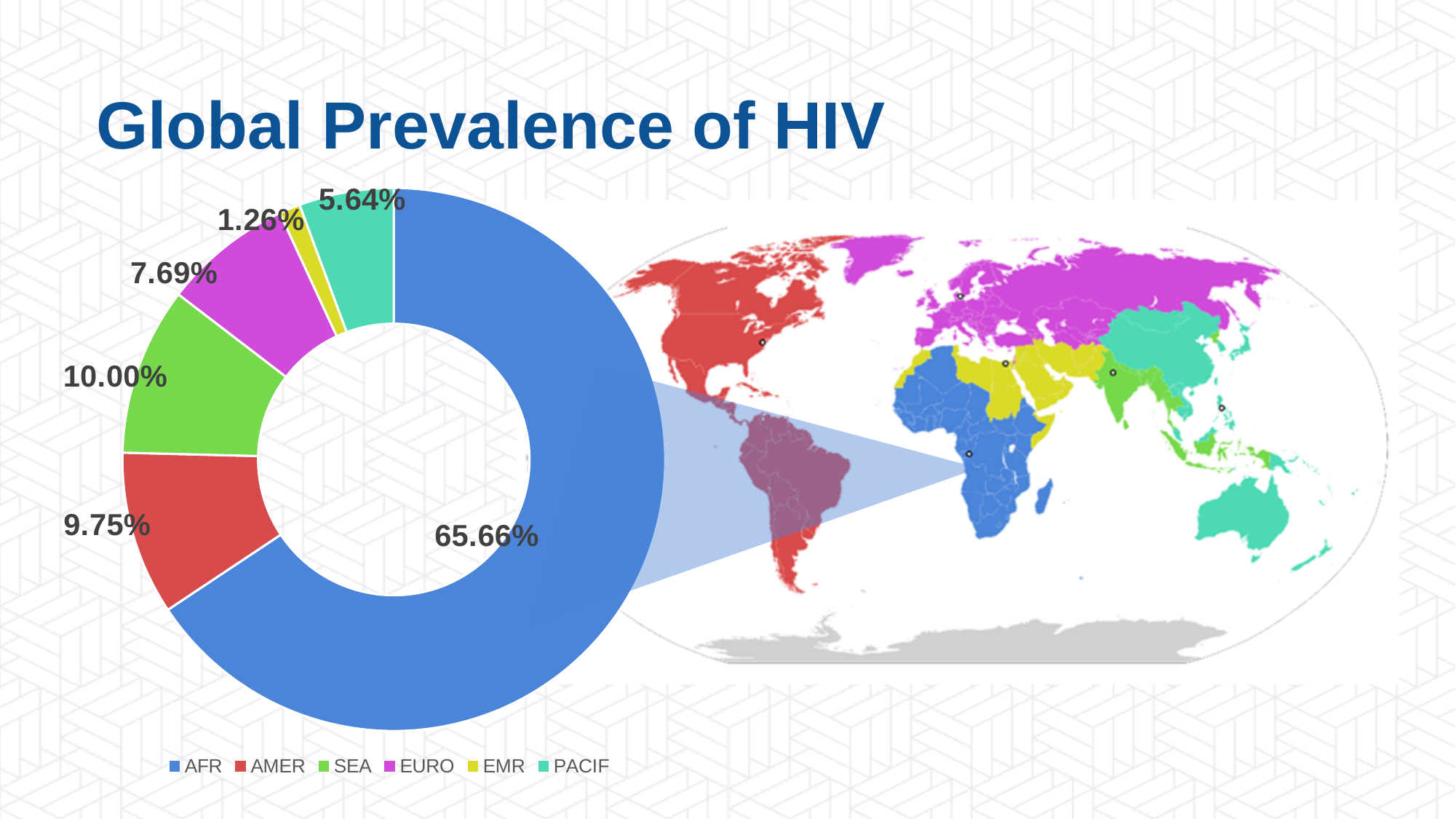
How many regions are shown in the chart? 6 What is the difference between the AFR and AMER values? 55.91% What percentage is labelled on the EMR slice? 1.26% What kind of chart is used on the slide? Doughnut chart Which is larger, the SEA value or the AMER value? SEA Which region has the largest slice in the chart? AFR What colour is the EURO slice in the chart? Purple What is the value for PACIF in the chart? 5.64% Which region has the smallest slice in the chart? EMR What is the difference between the EURO and PACIF values? 2.05% What share of the doughnut chart does AFR account for? 65.66% What is the value shown for the SEA slice? 10.00%